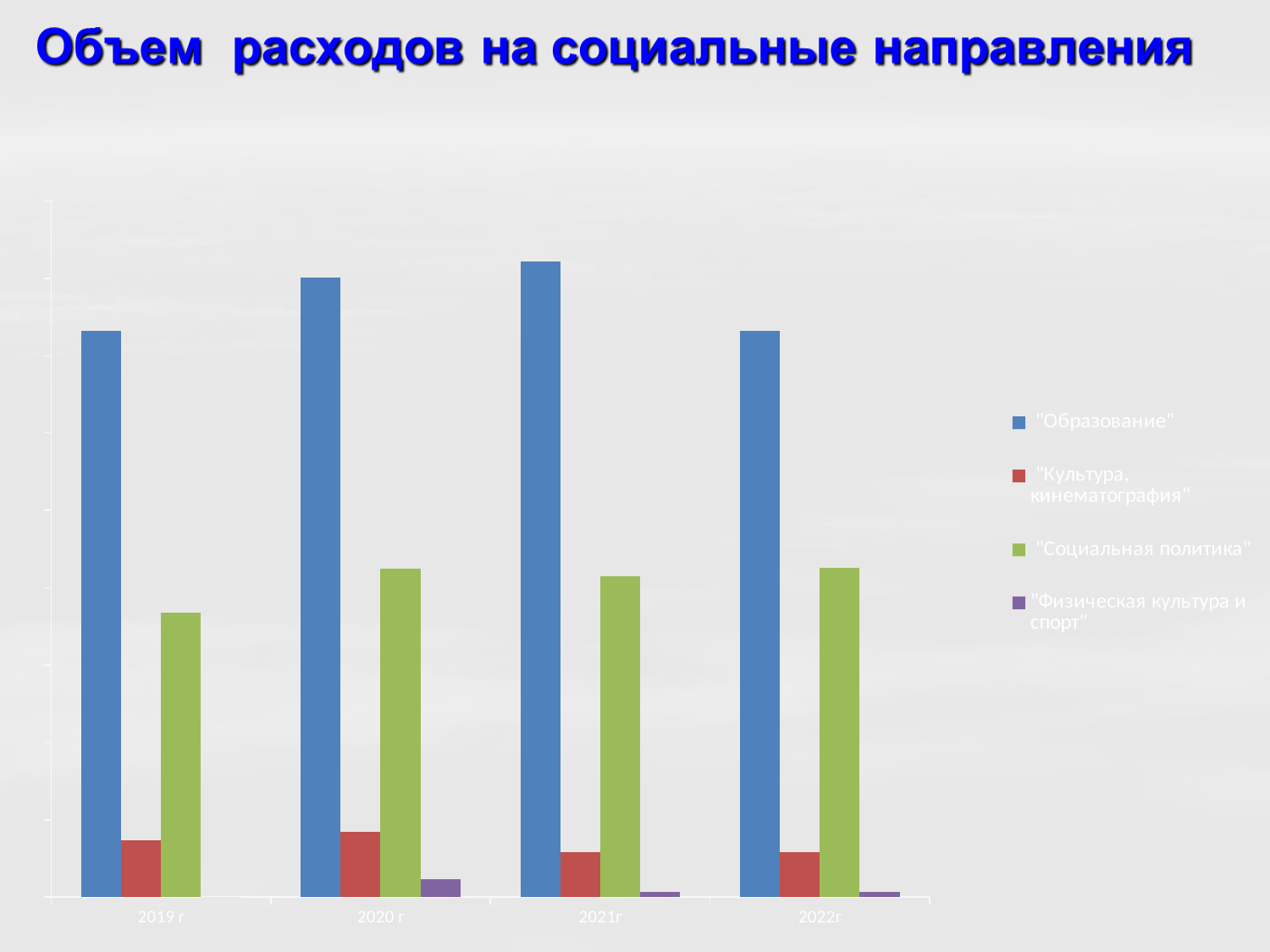
In which year is the value for "Образование" the highest? 2021г What kind of chart is shown on the slide? Bar chart What is the title of the slide containing the chart? Объем расходов на социальные направления In which year is the value for "Культура, кинематография" the highest? 2020 г How many series does the chart legend list? 4 Which is larger in 2022г: "Образование" or "Социальная политика"? "Образование" In which year is the value for "Социальная политика" the lowest? 2019 г Which series has the largest value in every year shown? "Образование" Which colour represents "Социальная политика" in the chart? Green In which year is the value for "Физическая культура и спорт" the highest? 2020 г Does the value for "Образование" rise or fall from 2019 г to 2021г? Rise How many years (categories) are shown on the x axis of the chart? 4